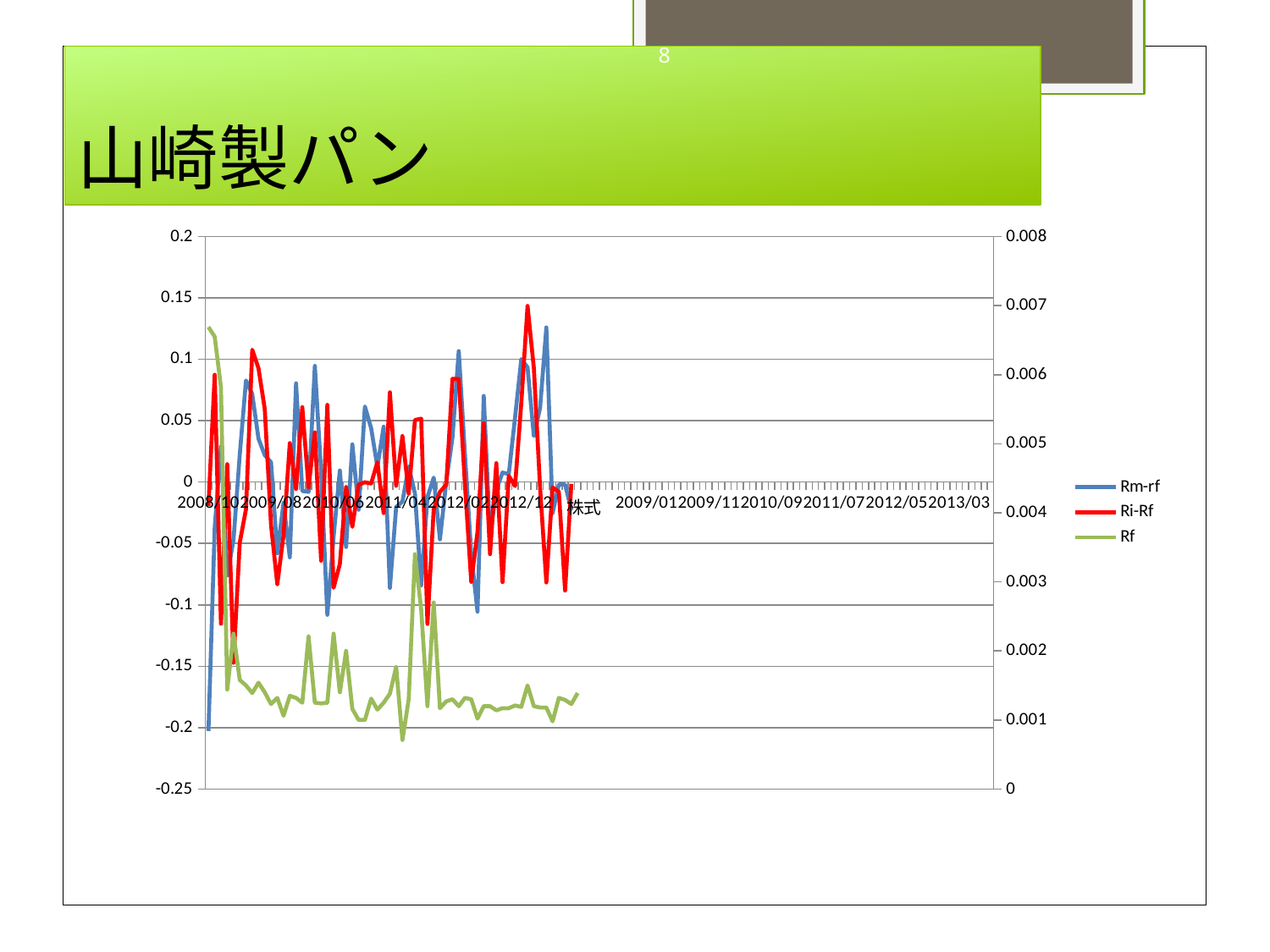
Is the first value of the Rf series greater or less than 0.006 on the right axis? greater Is the last value of the Rf series greater or less than 0.002 on the right axis? less What kind of chart is shown on the slide? line chart Which series reaches the lower minimum on the left axis, Rm-rf or Ri-Rf? Rm-rf Is the highest peak of the Rm-rf series greater or less than 0.15 on the left axis? less What are the three series named in the legend? Rm-rf, Ri-Rf, Rf Does the Rf series rise or fall over time along the x axis? fall Which colour is used for the Ri-Rf series? red How many series does the legend list? 3 Which series reaches the higher peak on the left axis, Rm-rf or Ri-Rf? Ri-Rf